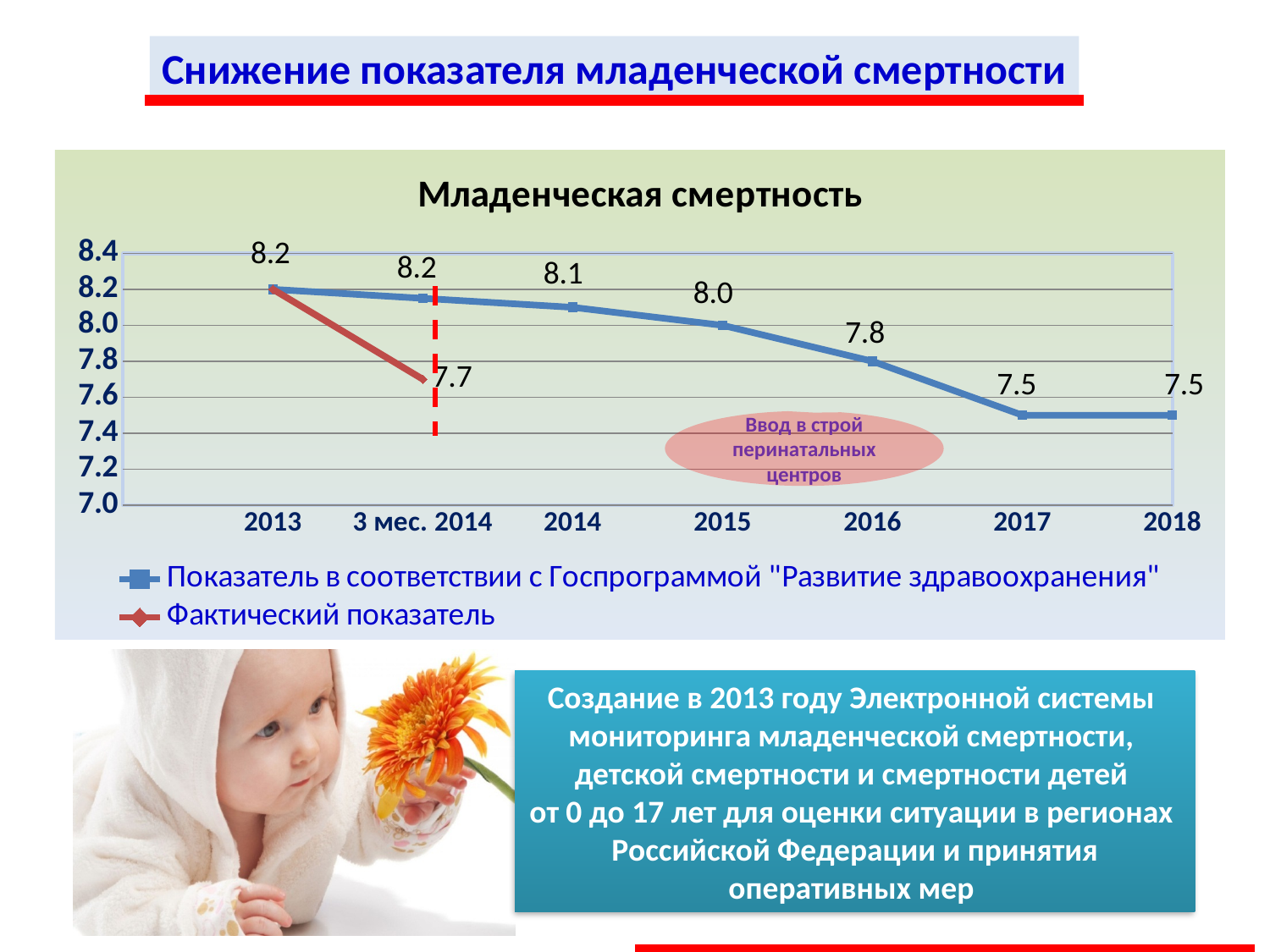
What is the value of the series "Показатель в соответствии с Госпрограммой" for 2016? 7.8 How many series does the chart legend list? 2 What is the value of the series "Фактический показатель" for "3 мес. 2014"? 7.7 What is the value of the series "Показатель в соответствии с Госпрограммой" for 2015? 8.0 Does the series "Показатель в соответствии с Госпрограммой" rise or fall from 2013 to 2018? fall For "3 мес. 2014", which series has the larger value: "Показатель в соответствии с Госпрограммой" or "Фактический показатель"? Показатель в соответствии с Госпрограммой What is the title of the chart? Младенческая смертность What type of chart is shown on the slide? line chart Which category has the lowest value for the series "Показатель в соответствии с Госпрограммой"? 2017 and 2018 What is the difference between the "Показатель в соответствии с Госпрограммой" value for 2013 and for 2017? 0.7 How many categories are shown on the x axis of the chart? 7 What is the value of the series "Показатель в соответствии с Госпрограммой" for 2018? 7.5